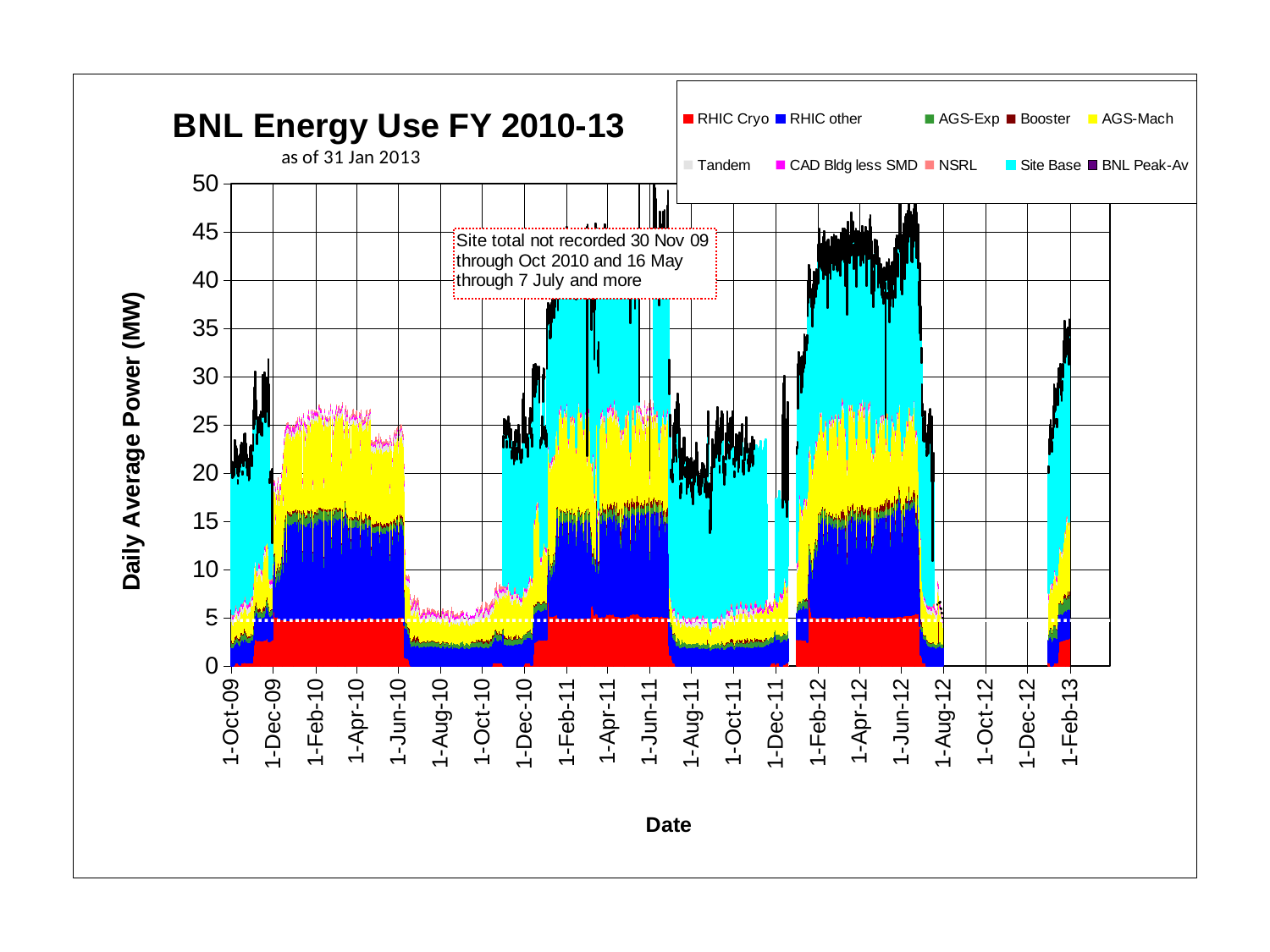
How many series does the legend list? 10 Is the total stacked value around 1-Aug-10 greater or less than 10? less Is the value of the BNL Peak-Av line around 1-Oct-11 greater or less than 30? less Is the value of the BNL Peak-Av line around 1-Apr-12 greater or less than 40? greater What kind of chart is shown on the slide? area chart What is the title of the chart? BNL Energy Use FY 2010-13 Which colour represents the Site Base series in the legend? cyan (light blue)